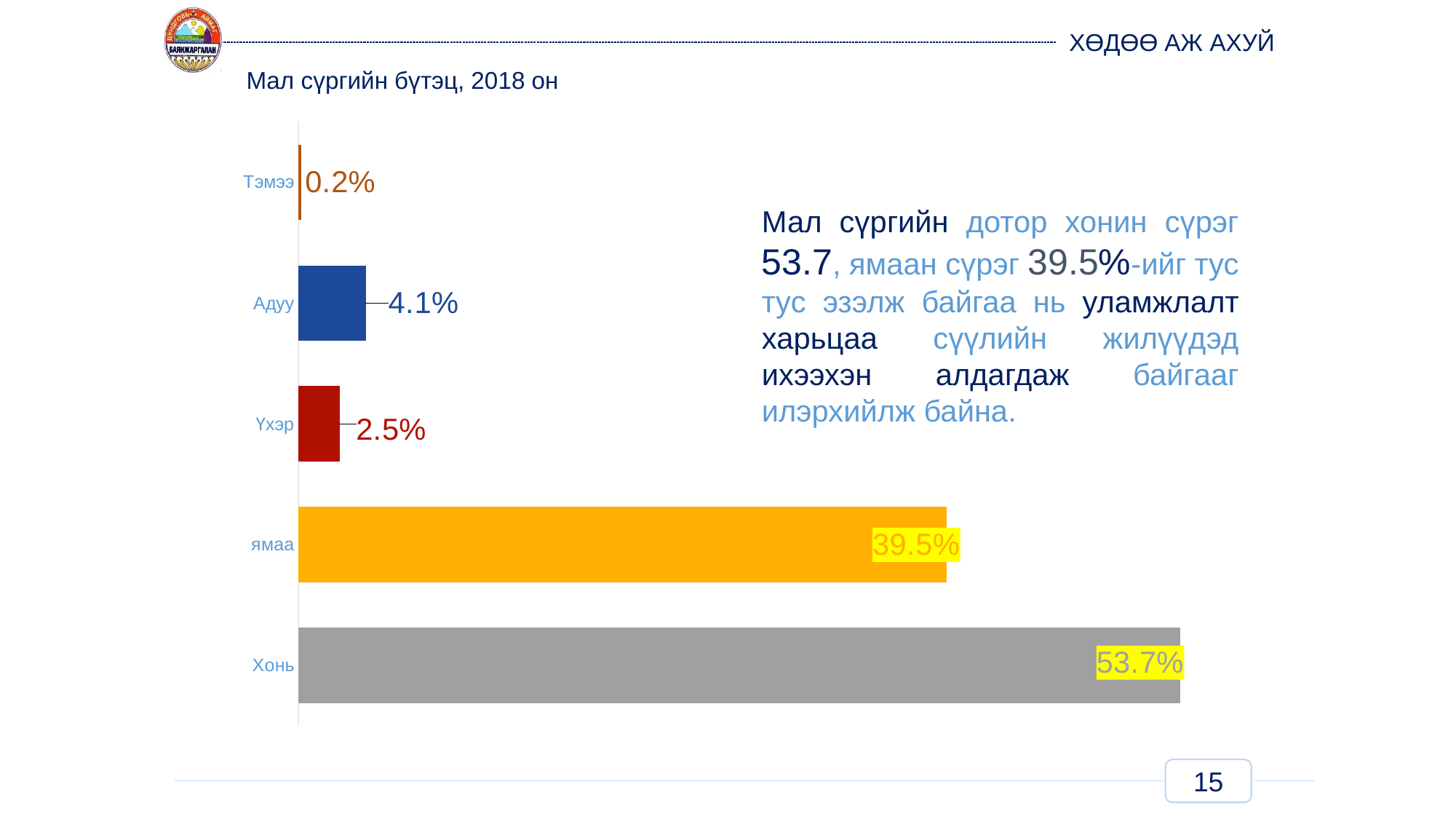
What is the value for Үхэр? 2.5% What is the difference between the values for Хонь and ямаа? 14.2% What is the value for Тэмээ? 0.2% What is the value for Хонь? 53.7% What kind of chart is shown on the slide? Bar chart What is the value for ямаа? 39.5% Which is larger, the value for Адуу or the value for Үхэр? Адуу Which category has the highest value? Хонь Which category has the lowest value? Тэмээ What is the value for Адуу? 4.1% How many categories are shown in the chart? 5 What is the title of the chart? Мал сүргийн бүтэц, 2018 он